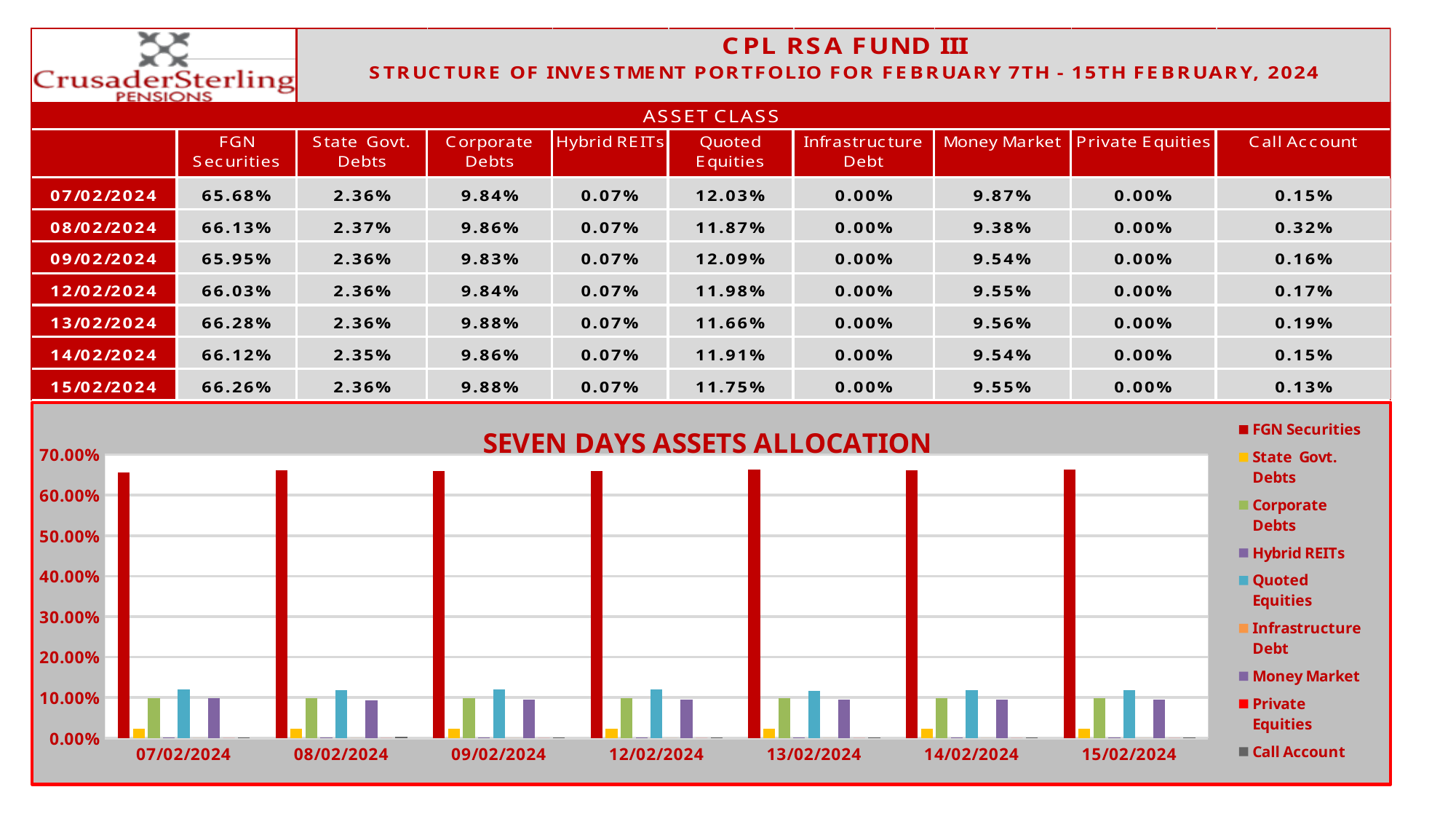
In the 'SEVEN DAYS ASSETS ALLOCATION' chart, is the value for Quoted Equities on 15/02/2024 greater or less than 20.00%? less In the 'SEVEN DAYS ASSETS ALLOCATION' chart, which is larger on 09/02/2024: Quoted Equities or Corporate Debts? Quoted Equities What colour are the FGN Securities bars in the 'SEVEN DAYS ASSETS ALLOCATION' chart? red In the 'SEVEN DAYS ASSETS ALLOCATION' chart, which asset class has the tallest bar on every date? FGN Securities According to the table above the chart, what is the difference between the Quoted Equities allocation on 07/02/2024 and on 15/02/2024? 0.28% What kind of chart is the 'SEVEN DAYS ASSETS ALLOCATION' chart? bar chart According to the table above the chart, what is the FGN Securities allocation on 13/02/2024? 66.28% In the 'SEVEN DAYS ASSETS ALLOCATION' chart, is the value for FGN Securities on 07/02/2024 greater or less than 60.00%? greater What is the title of the chart on the slide? SEVEN DAYS ASSETS ALLOCATION In the 'SEVEN DAYS ASSETS ALLOCATION' chart, is the value for State Govt. Debts on 12/02/2024 greater or less than 10.00%? less How many series does the legend of the 'SEVEN DAYS ASSETS ALLOCATION' chart list? 9 How many dates are shown along the x axis of the 'SEVEN DAYS ASSETS ALLOCATION' chart? 7